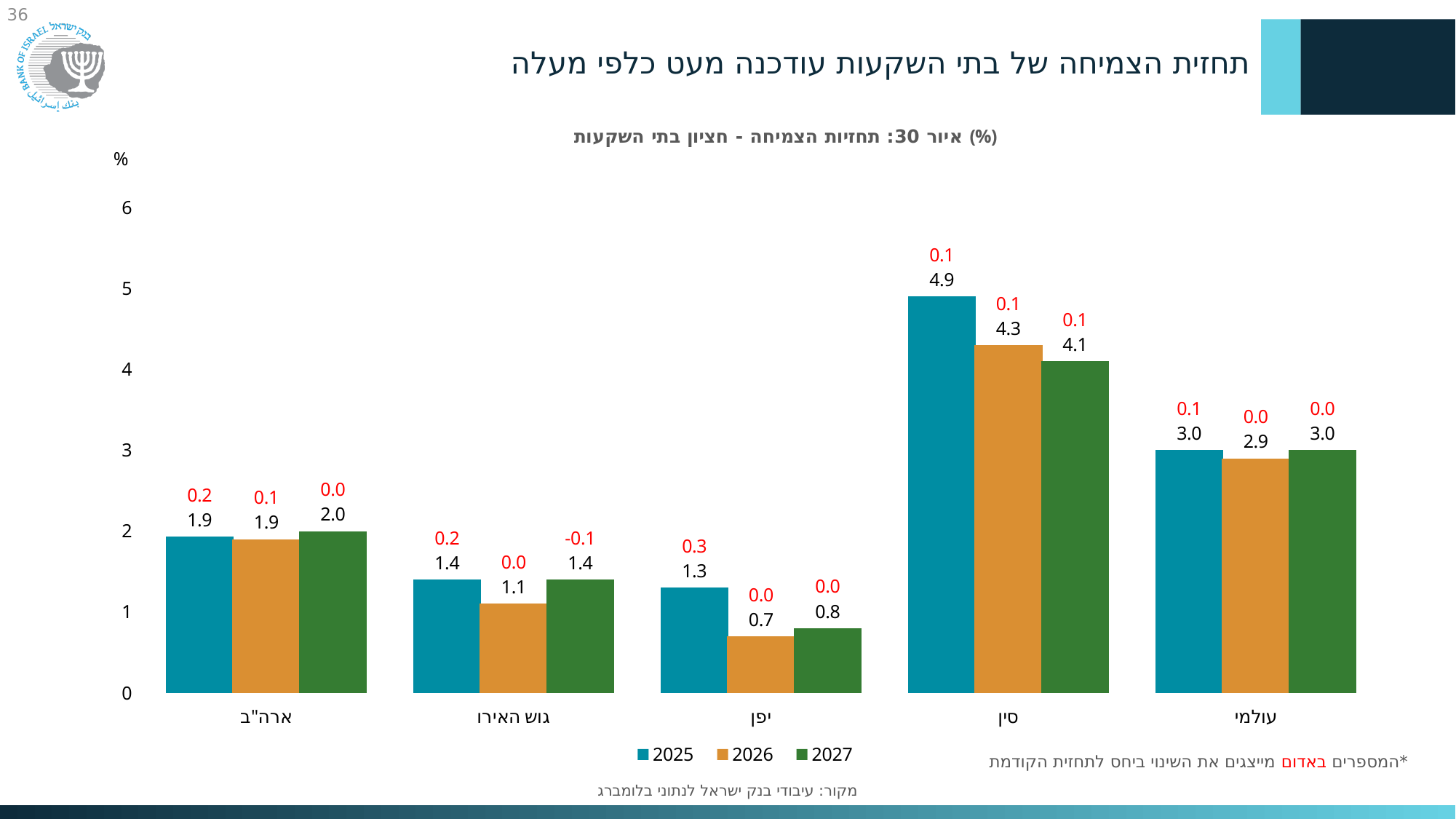
Which category has the lowest 2026 value? יפן Which is larger: the 2025 value for ארה"ב or the 2025 value for גוש האירו? ארה"ב Which category has the highest 2025 value? סין What kind of chart is shown on the slide? bar chart What is the 2026 value for עולמי? 2.9 What is the 2025 value for סין? 4.9 How many series does the legend list? 3 How many categories are shown on the x axis? 5 What is the 2027 value for גוש האירו? 1.4 What is the red number shown above the 2027 bar for גוש האירו? -0.1 What is the 2026 value for יפן? 0.7 What is the difference between the 2025 and 2027 values for סין? 0.8